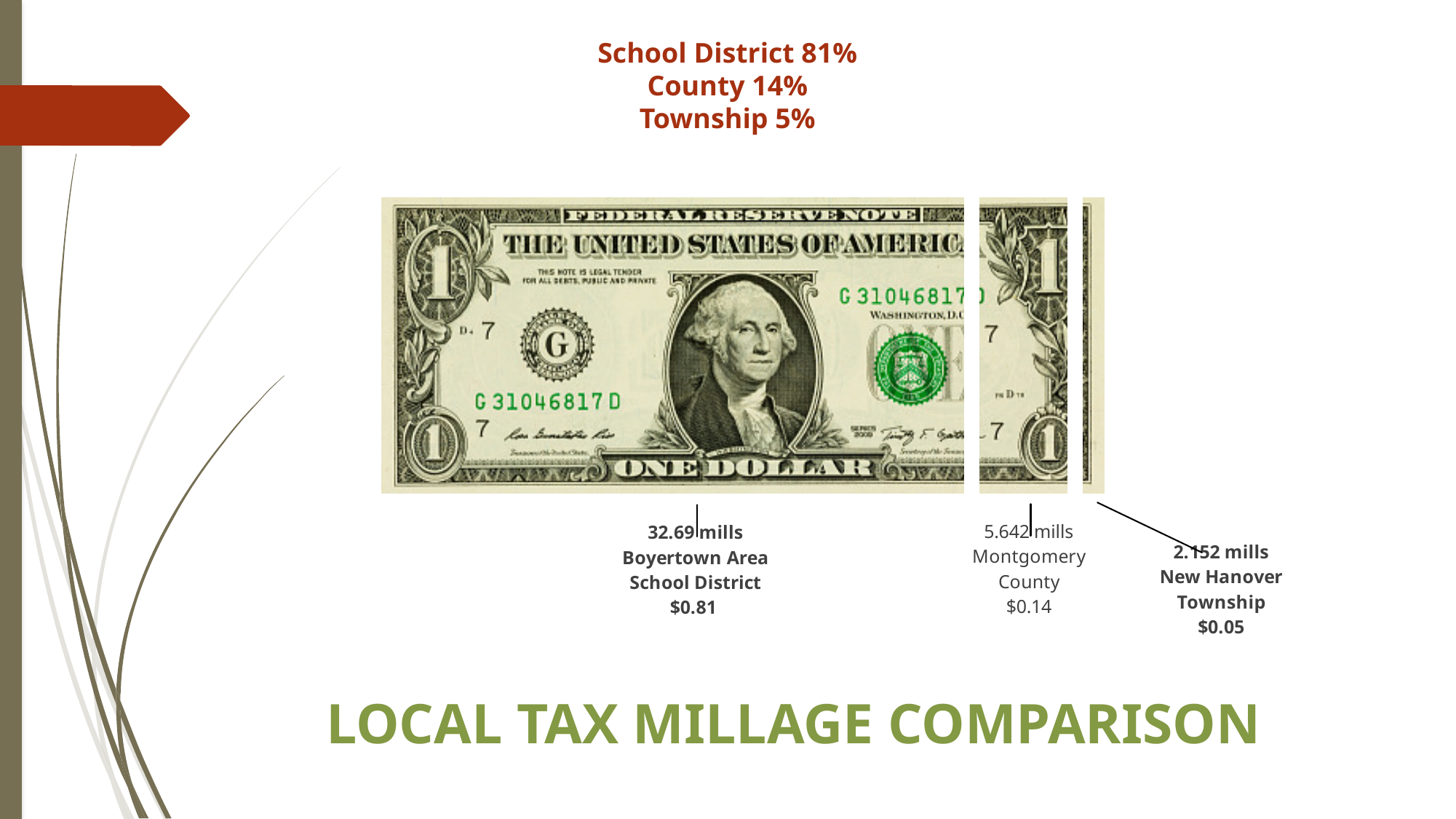
How many mills does Montgomery County levy? 5.642 mills Into how many segments is the dollar bill divided? 3 How much of each dollar goes to Montgomery County? $0.14 How many mills does New Hanover Township levy? 2.152 mills What percentage of the local tax dollar goes to the School District? 81% What is the difference in percentage points between the School District share and the County share? 67 percentage points How many mills does the Boyertown Area School District levy? 32.69 mills Which taxing body receives the largest share of the local tax dollar? Boyertown Area School District What is the title of the slide? LOCAL TAX MILLAGE COMPARISON Which taxing body receives the smallest share of the local tax dollar? New Hanover Township What percentage of the local tax dollar goes to the Township? 5% What percentage of the local tax dollar goes to the County? 14%